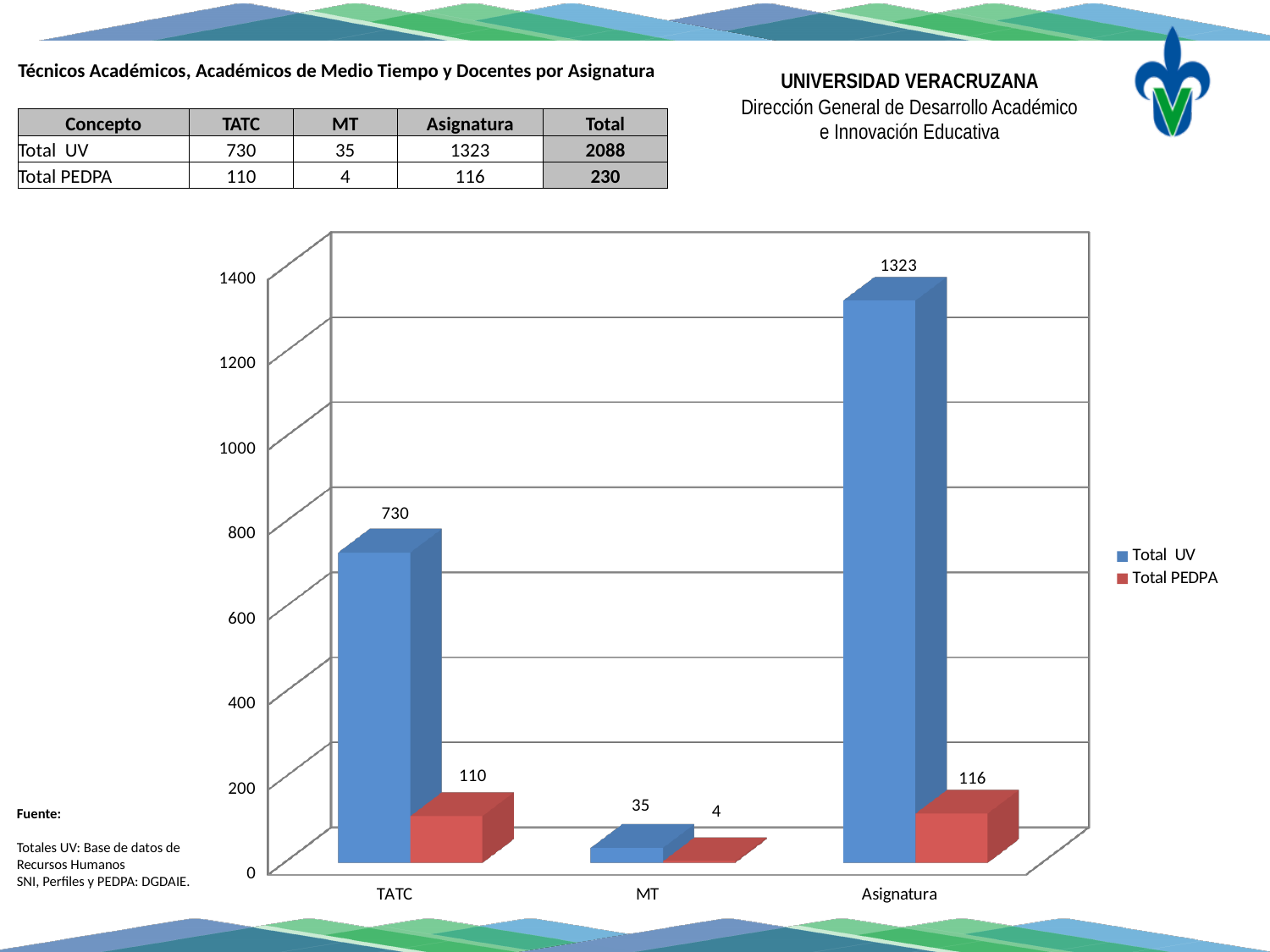
Which is larger, the Total PEDPA value for TATC or for Asignatura? Asignatura What is the Total UV value for TATC? 730 What is the Total UV value for MT? 35 What is the Total PEDPA value for MT? 4 Which colour represents the Total PEDPA series? Red How many series does the legend list? 2 How many categories are shown on the x axis? 3 What kind of chart is shown on the slide? Bar chart What is the difference between the Total UV and Total PEDPA values for TATC? 620 Which category has the lowest Total PEDPA value? MT Which category has the highest Total UV value? Asignatura What is the Total PEDPA value for Asignatura? 116